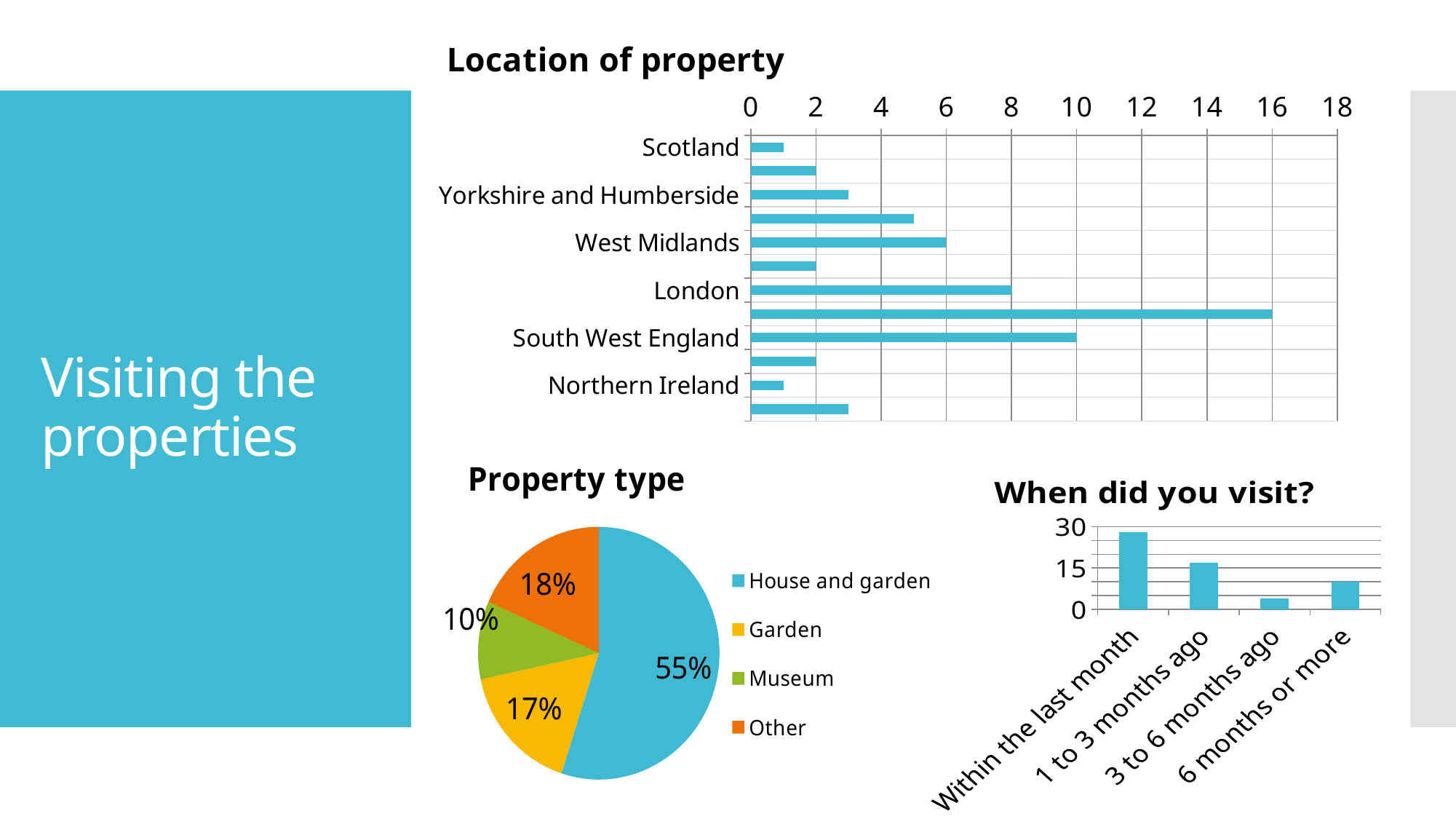
In the 'Property type' chart, what share does House and garden have? 55% In the 'Location of property' chart, which is larger, London or West Midlands? London In the 'Property type' chart, which property type has the smallest share? Museum In the 'When did you visit?' chart, is the value for '3 to 6 months ago' greater or less than 15? less In the 'Location of property' chart, what is the value for South West England? 10 In the 'Location of property' chart, is the value for Yorkshire and Humberside greater or less than 4? less In the 'Location of property' chart, what is the value for London? 8 In the 'Location of property' chart, is the value for Scotland greater or less than 2? less In the 'When did you visit?' chart, which category has the highest value? Within the last month How many entries does the legend of the 'Property type' chart list? 4 In the 'Location of property' chart, what is the value for West Midlands? 6 In the 'Property type' chart, what is the difference between the House and garden share and the Garden share? 38%